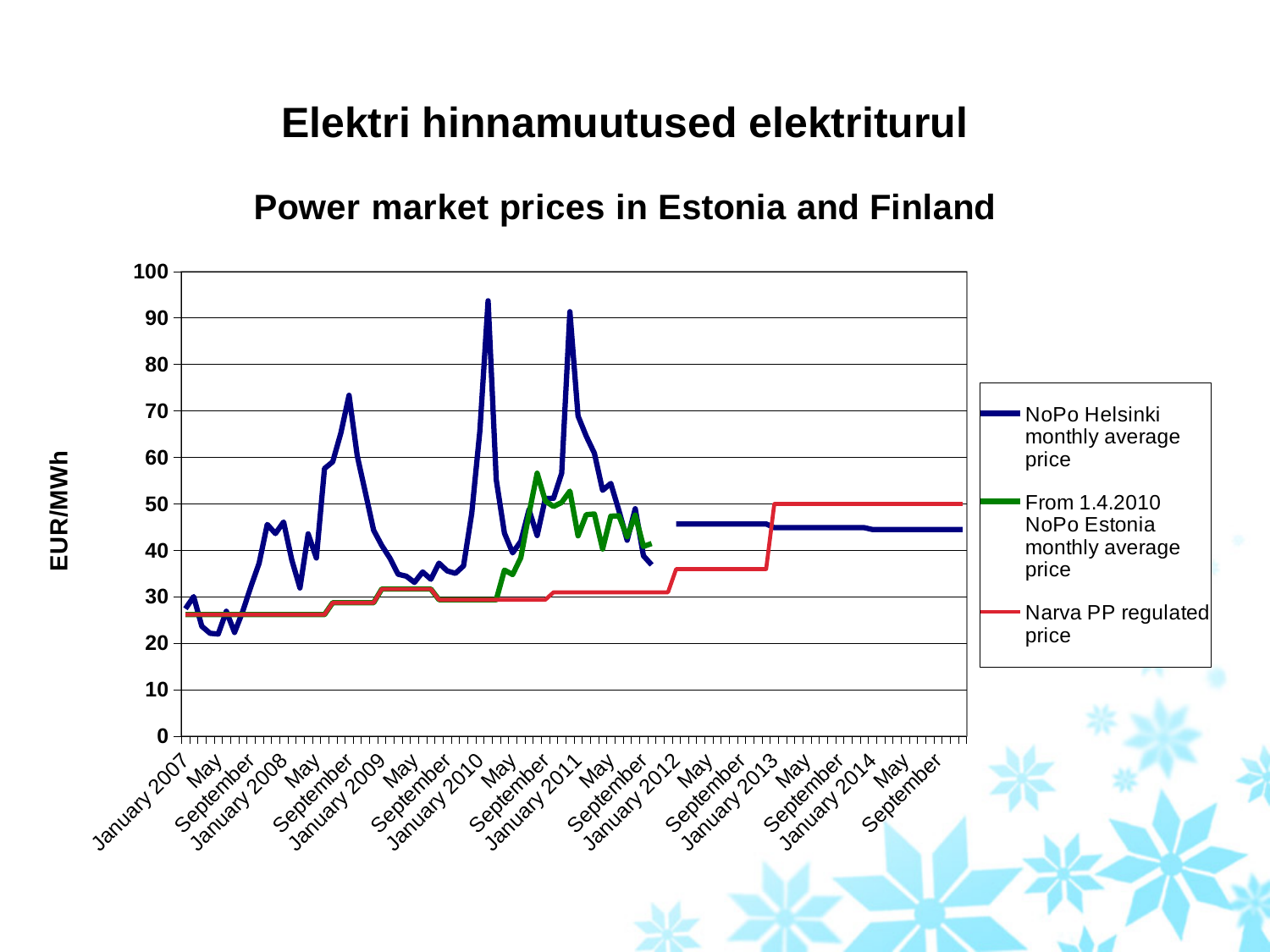
Is the peak value of the NoPo Helsinki monthly average price in early 2010 greater or less than 90? greater Which series reaches the highest value on the chart? NoPo Helsinki monthly average price What is the title of the chart? Power market prices in Estonia and Finland Which is larger: the highest value of the NoPo Helsinki monthly average price or the highest value of the Narva PP regulated price? NoPo Helsinki monthly average price Is the Narva PP regulated price in January 2007 greater or less than 30? less Is the NoPo Helsinki monthly average price in 2013 greater or less than 40? greater What kind of chart is shown on the slide? line chart How many series does the legend list? 3 Does the Narva PP regulated price rise or fall from January 2007 to 2014? rise What unit is shown on the vertical axis label? EUR/MWh